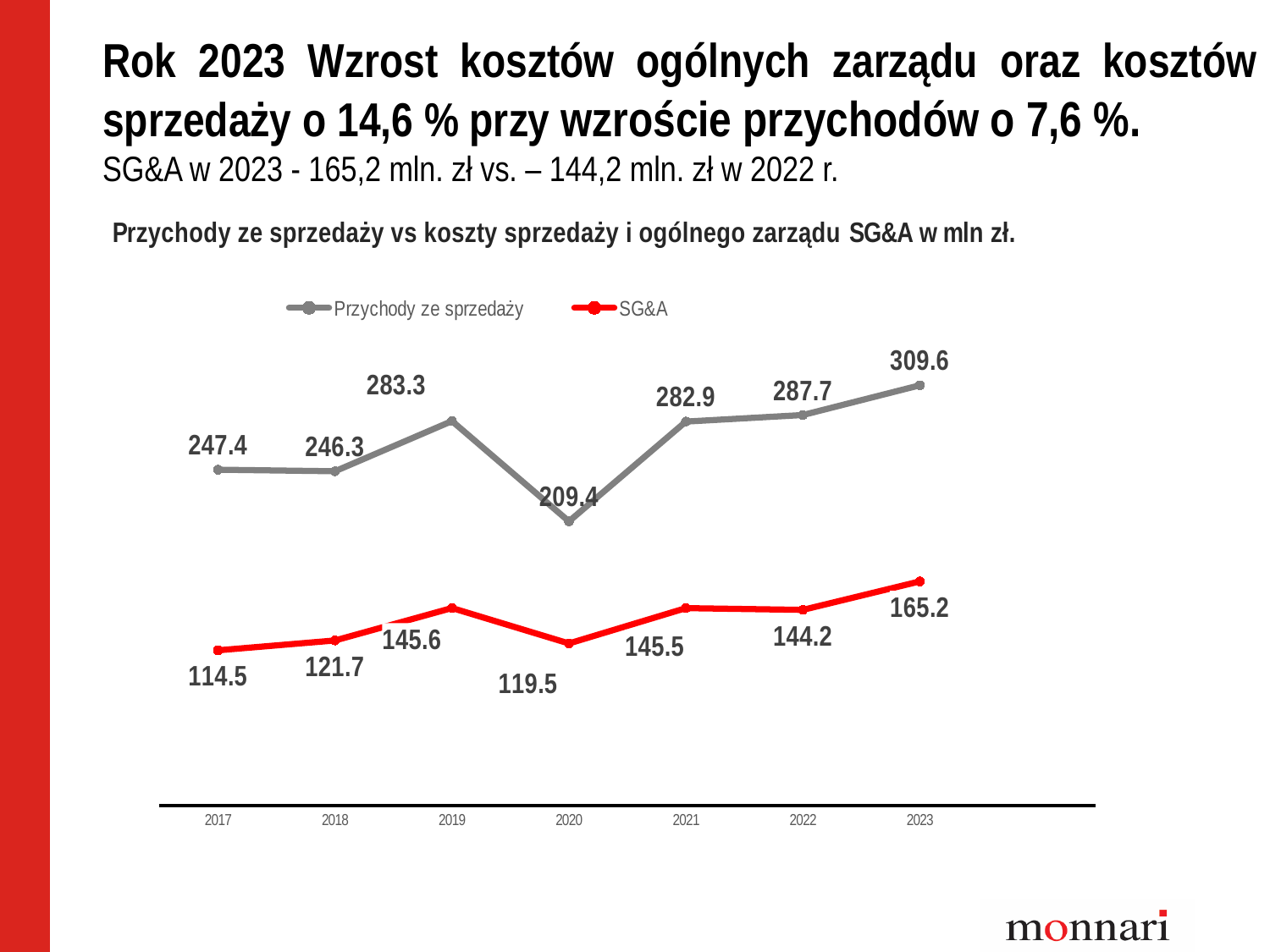
How many series does the legend list? 2 In which year is Przychody ze sprzedaży lowest? 2020 Which is larger: Przychody ze sprzedaży in 2019 or in 2021? 2019 What is the difference between SG&A in 2023 and SG&A in 2022? 21.0 What is the value of Przychody ze sprzedaży for 2023? 309.6 In which year is SG&A highest? 2023 In which year is SG&A lowest? 2017 What is the difference between Przychody ze sprzedaży and SG&A in 2023? 144.4 What kind of chart is shown on the slide? Line chart What is the value of Przychody ze sprzedaży for 2017? 247.4 How many years are shown on the x axis? 7 What is the SG&A value for 2020? 119.5